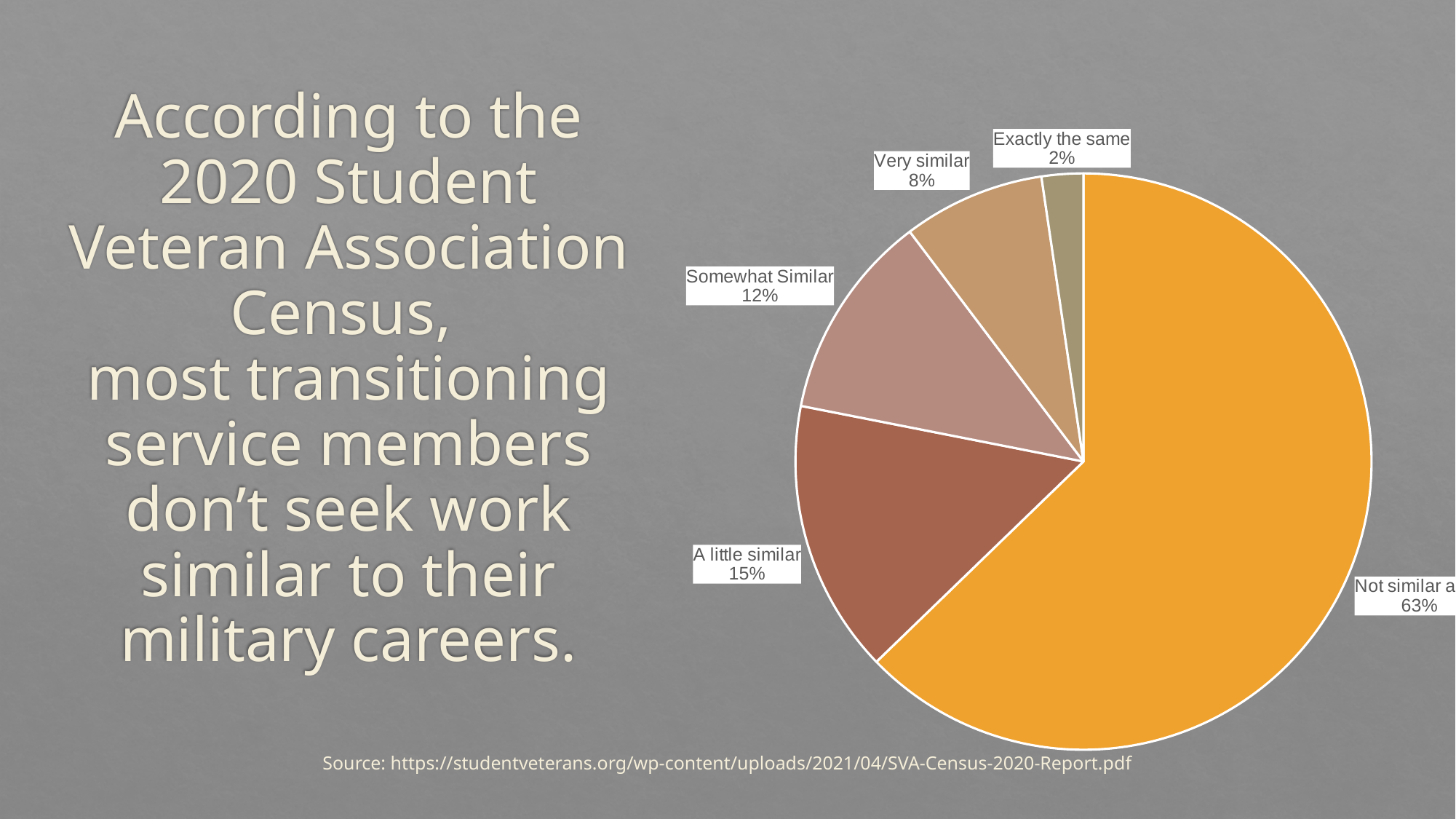
What percentage is shown for the "Somewhat Similar" slice? 12% What percentage is shown for the "A little similar" slice? 15% What percentage is shown for the "Not similar" slice? 63% What percentage is shown for the "Exactly the same" slice? 2% Which slice of the pie chart is the smallest? Exactly the same How many slices does the pie chart have? 5 What colour is the largest slice of the pie chart? orange Which slice of the pie chart is the largest? Not similar What kind of chart is shown on the slide? pie chart What percentage is shown for the "Very similar" slice? 8% Which is larger, the "Somewhat Similar" slice or the "Very similar" slice? Somewhat Similar What is the difference in percentage points between the "A little similar" and "Very similar" slices? 7